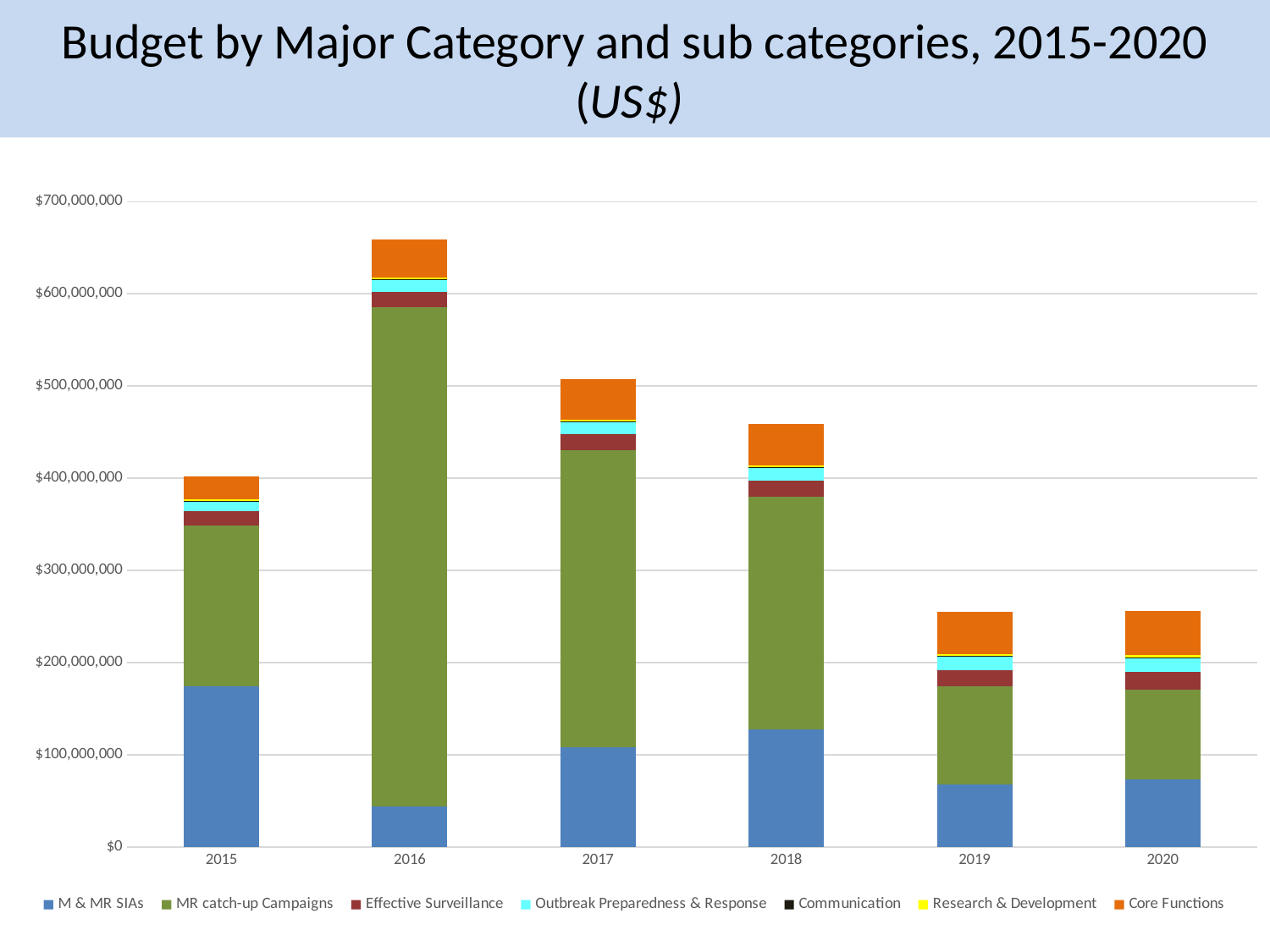
Which year has the larger total budget, 2017 or 2018? 2017 Which year has the largest M & MR SIAs segment? 2015 Is the total budget for 2019 greater or less than $200,000,000? greater How many series does the legend list? 7 Which series is shown in orange at the top of each bar? Core Functions What kind of chart is shown on the slide? Stacked bar chart Is the total budget for 2016 greater or less than $600,000,000? greater Do the total budgets rise or fall from 2016 to 2019? fall How many years are shown on the x axis of the chart? 6 Which year has the highest total budget? 2016 Is the total budget for 2018 greater or less than $500,000,000? less Which year has the smallest M & MR SIAs segment? 2016